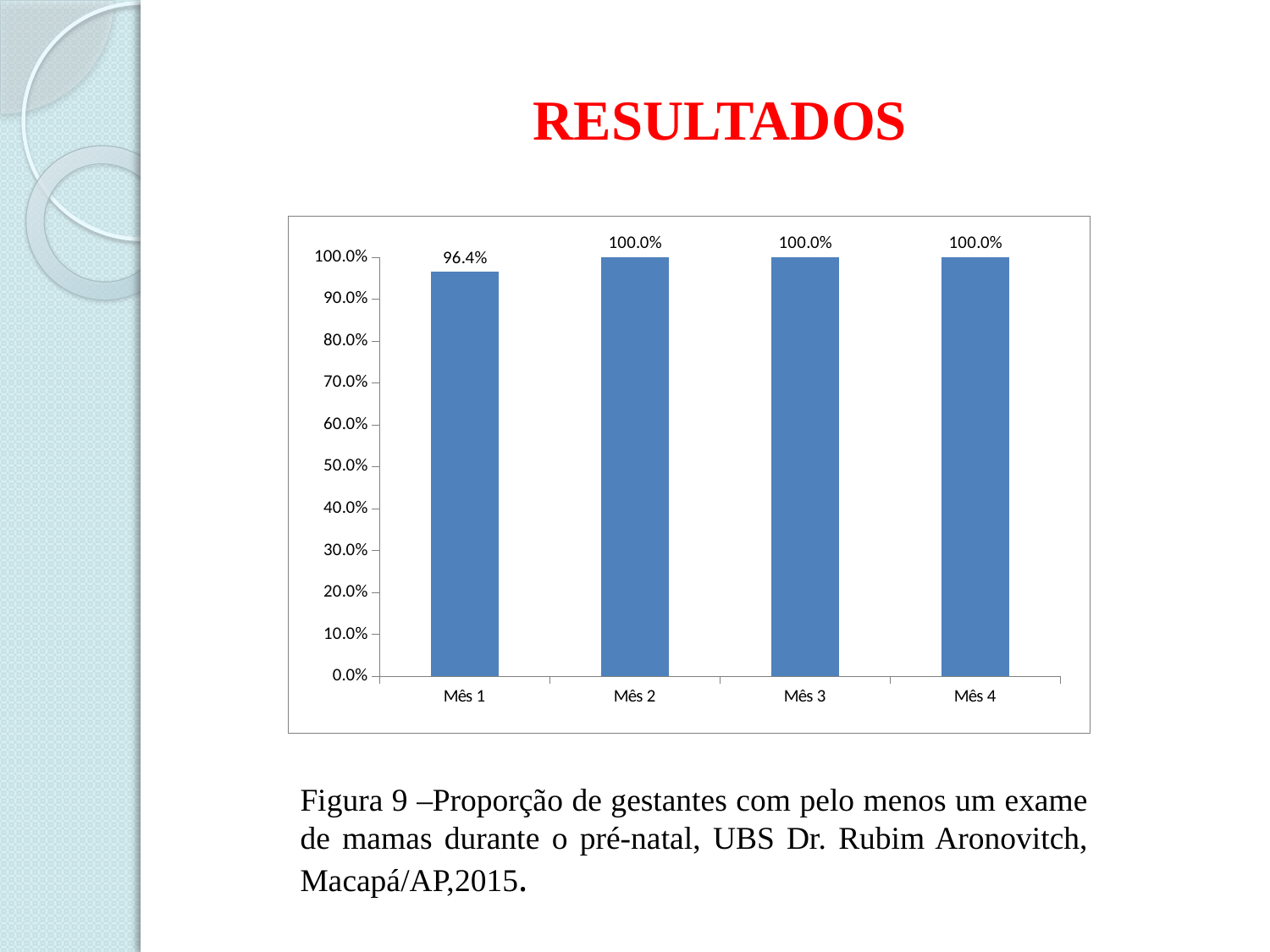
What is the value for Mês 3? 100.0% How many months are shown on the x axis? 4 What is the difference between the values for Mês 2 and Mês 1? 3.6% Do the values rise or fall from Mês 1 to Mês 2? rise Which is larger, the value for Mês 1 or the value for Mês 4? Mês 4 How many months reach 100.0%? 3 Is the value for Mês 1 greater or less than 90.0%? greater What colour are the bars in the chart? blue What is the highest value shown on the y axis? 100.0% Which month has the lowest value? Mês 1 What is the value for Mês 1? 96.4% What kind of chart is shown on the slide? bar chart